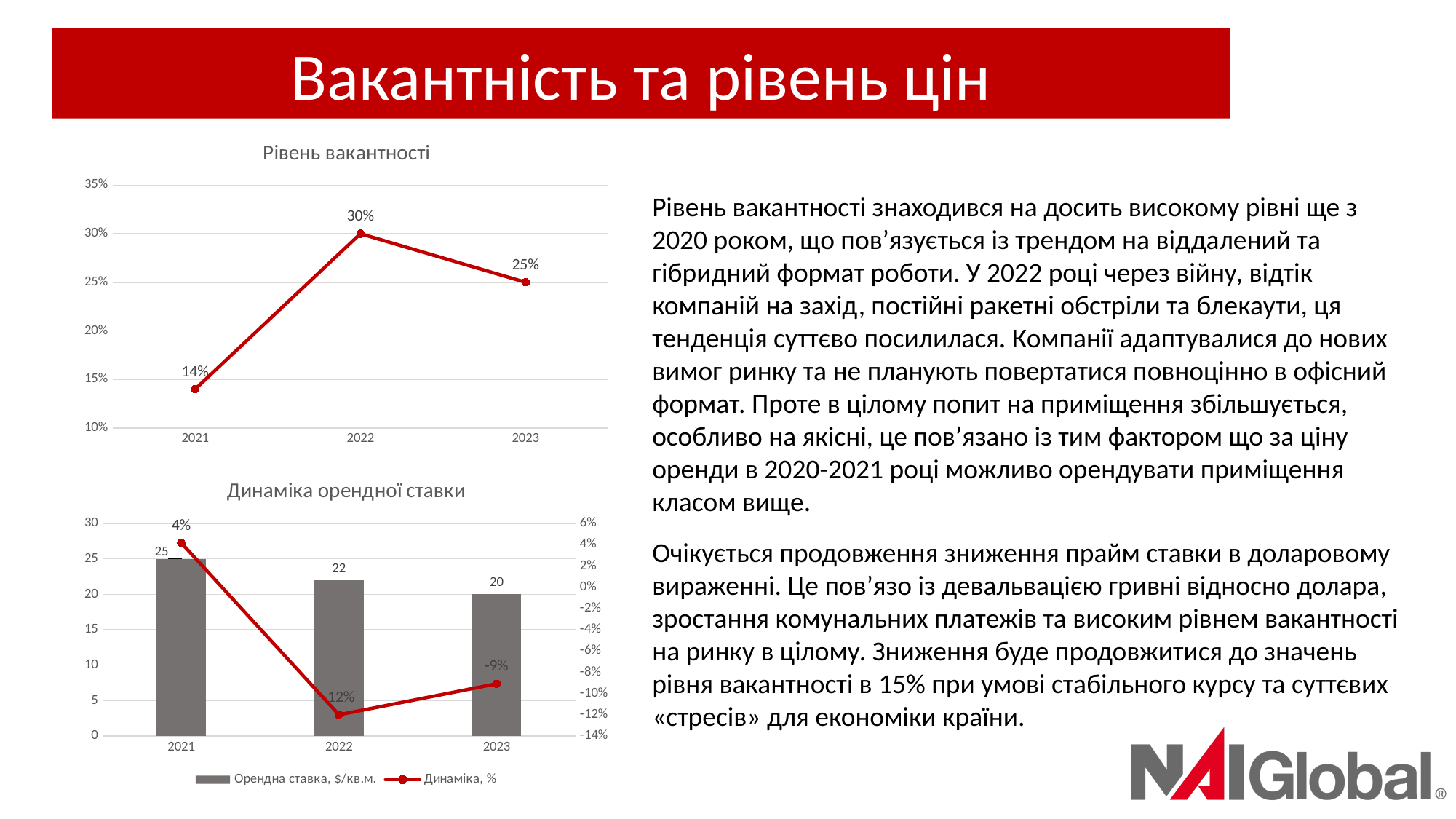
In the 'Динаміка орендної ставки' chart, which year has the highest rental rate bar? 2021 In the 'Динаміка орендної ставки' chart, what is the rental rate (Орендна ставка) for 2023? 20 In the 'Динаміка орендної ставки' chart, do the rental rate bars rise or fall from 2021 to 2023? Fall In the 'Рівень вакантності' chart, what is the difference between the 2022 and 2023 values? 5% In the 'Динаміка орендної ставки' chart, what is the 'Динаміка, %' value for 2022? -12% In the 'Динаміка орендної ставки' chart, is the 'Динаміка, %' value for 2021 larger or smaller than the value for 2023? Larger In the 'Рівень вакантності' chart, which year has the lowest vacancy rate? 2021 What kind of chart is 'Рівень вакантності'? Line chart In the 'Динаміка орендної ставки' chart, what is the difference between the rental rate in 2021 and in 2023? 5 In the 'Рівень вакантності' chart, what is the vacancy rate for 2022? 30% In the 'Рівень вакантності' chart, how many years are plotted on the x axis? 3 How many series does the legend of the 'Динаміка орендної ставки' chart list? 2